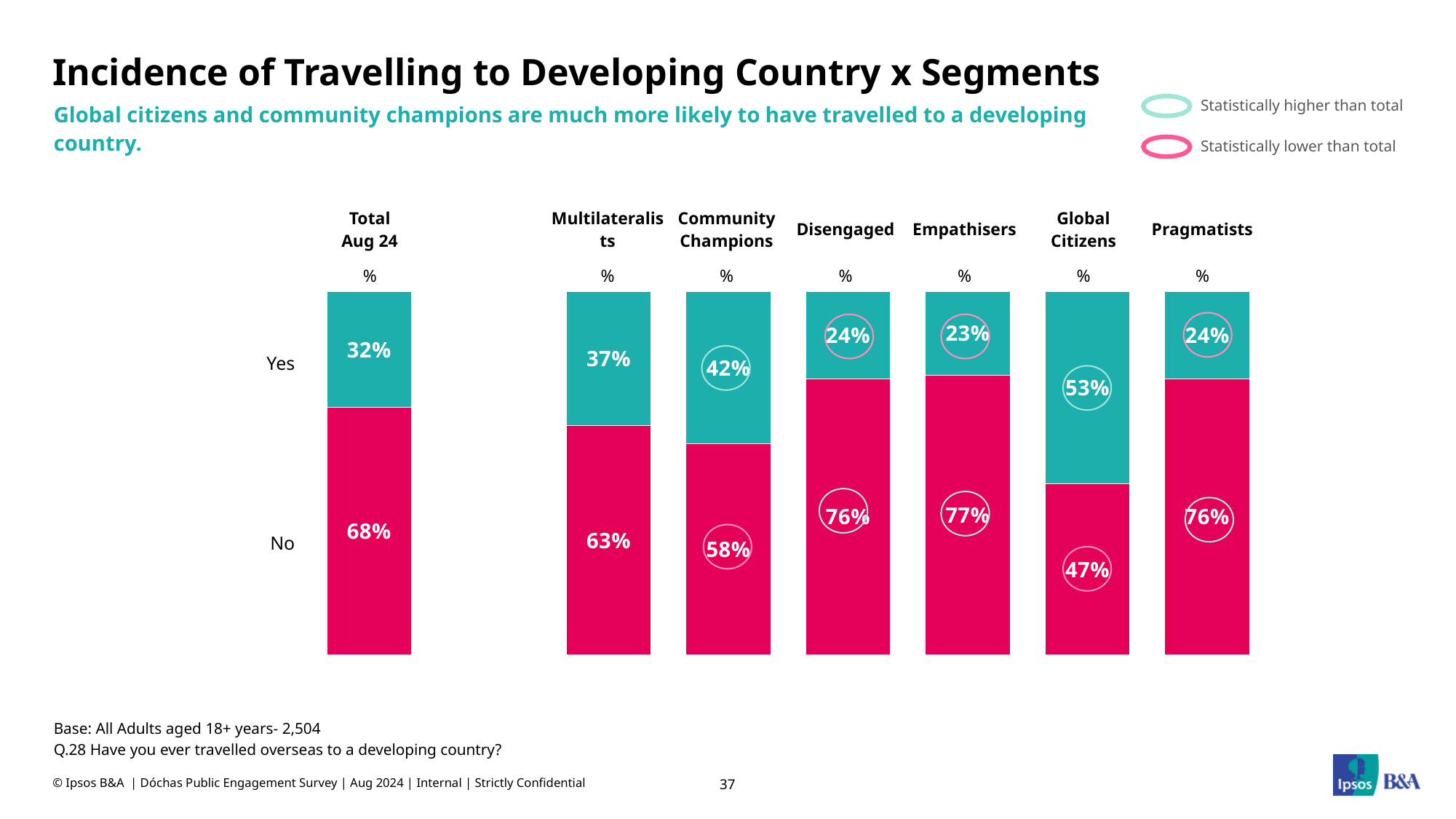
What is the No percentage for Empathisers? 77% Which segment has the highest Yes percentage? Global Citizens What percentage of Global Citizens answered No? 47% What is the total of the Yes and No values for the Disengaged bar? 100% What percentage of the Total Aug 24 group answered Yes? 32% What type of chart is shown on the slide? Stacked bar chart Which is larger, the Yes value for Multilateralists or the Yes value for Pragmatists? Multilateralists What does a pink circle around a value indicate according to the legend? Statistically lower than total How many segment bars are shown in addition to the Total Aug 24 bar? 6 What is the difference between the Yes percentage for Global Citizens and the Total Aug 24 Yes percentage? 21 percentage points What is the Yes value for Community Champions? 42% Which segment has the lowest Yes percentage? Empathisers